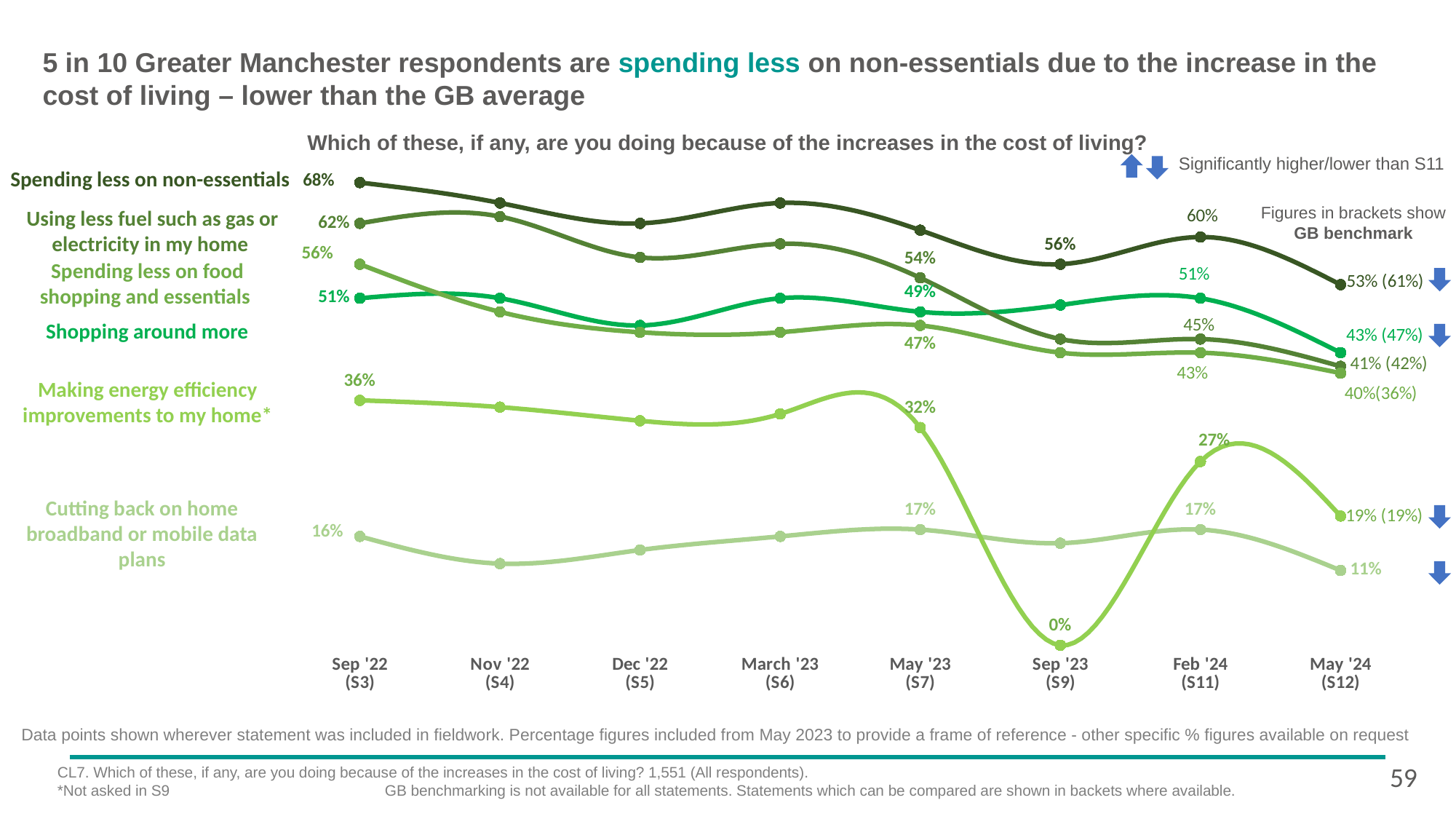
Which statement has the highest value in Sep '22 (S3)? Spending less on non-essentials What value is shown for cutting back on home broadband or mobile data plans in May '24 (S12)? 11% In Feb '24, which is higher: making energy efficiency improvements to my home or cutting back on home broadband or mobile data plans? Making energy efficiency improvements to my home What kind of chart is shown on the slide? Line chart By how many percentage points did spending less on non-essentials fall from Sep '22 (68%) to May '24 (53%)? 15 percentage points What value is shown for making energy efficiency improvements to my home in Sep '23 (S9)? 0% What percentage of respondents were spending less on non-essentials in May '24 (S12)? 53% How many survey waves (time points) are shown on the x axis? 8 Which statement has the lowest value in May '24 (S12)? Cutting back on home broadband or mobile data plans What percentage of respondents were spending less on non-essentials in Sep '22 (S3)? 68% What value is shown for making energy efficiency improvements to my home in Feb '24 (S11)? 27% What is the GB benchmark shown in brackets for spending less on non-essentials in May '24? 61%